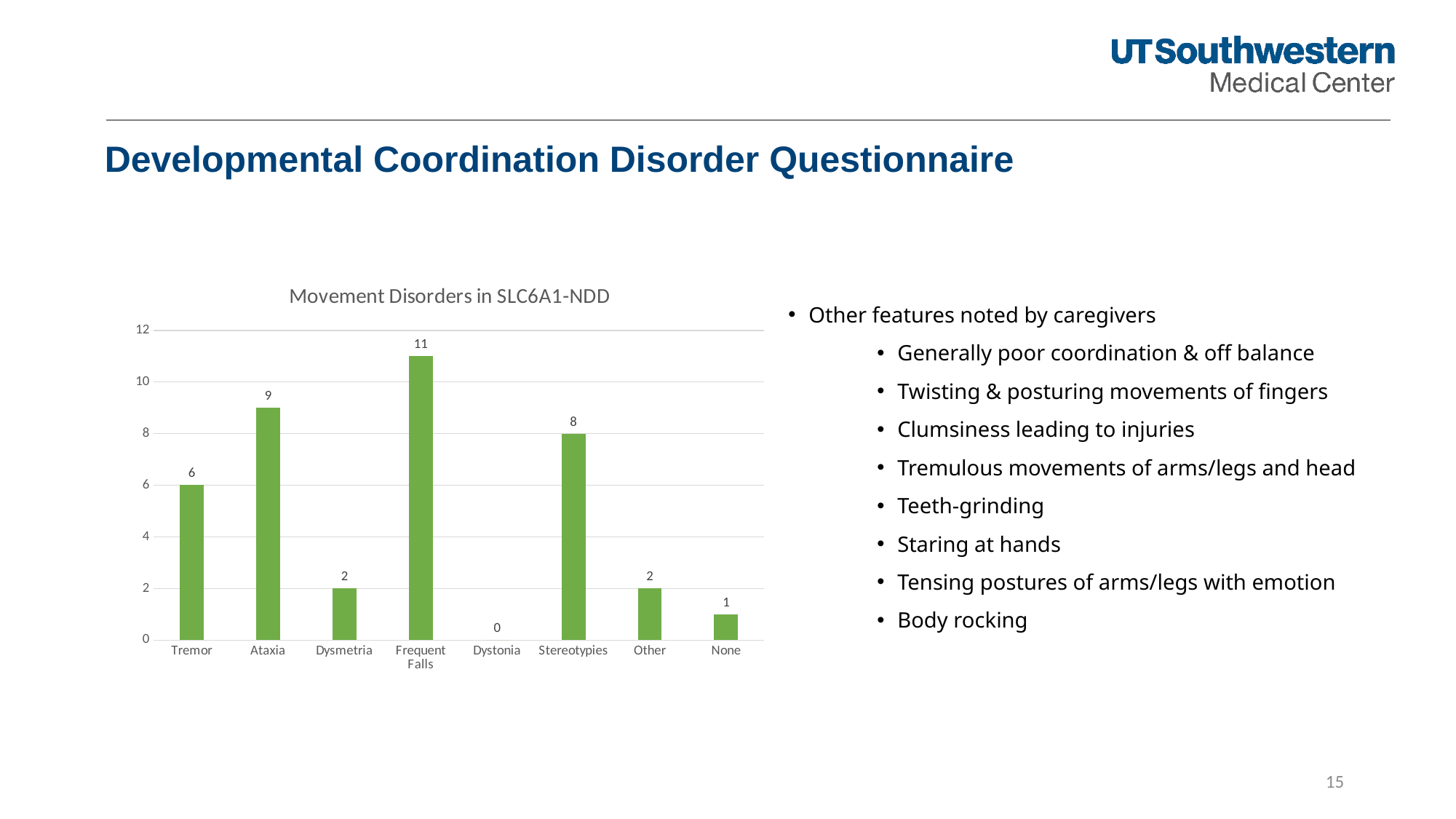
Is the value for Tremor greater or less than 4? greater What is the title of the chart? Movement Disorders in SLC6A1-NDD What is the value for Stereotypies? 8 What is the value for Frequent Falls? 11 What kind of chart is shown on the slide? Bar chart Which is larger, the value for Ataxia or the value for Stereotypies? Ataxia What is the value for Dystonia? 0 Which category has the lowest value? Dystonia What is the value for Ataxia? 9 Which category has the highest value? Frequent Falls What is the difference between the values for Frequent Falls and Tremor? 5 How many categories are shown on the x axis? 8